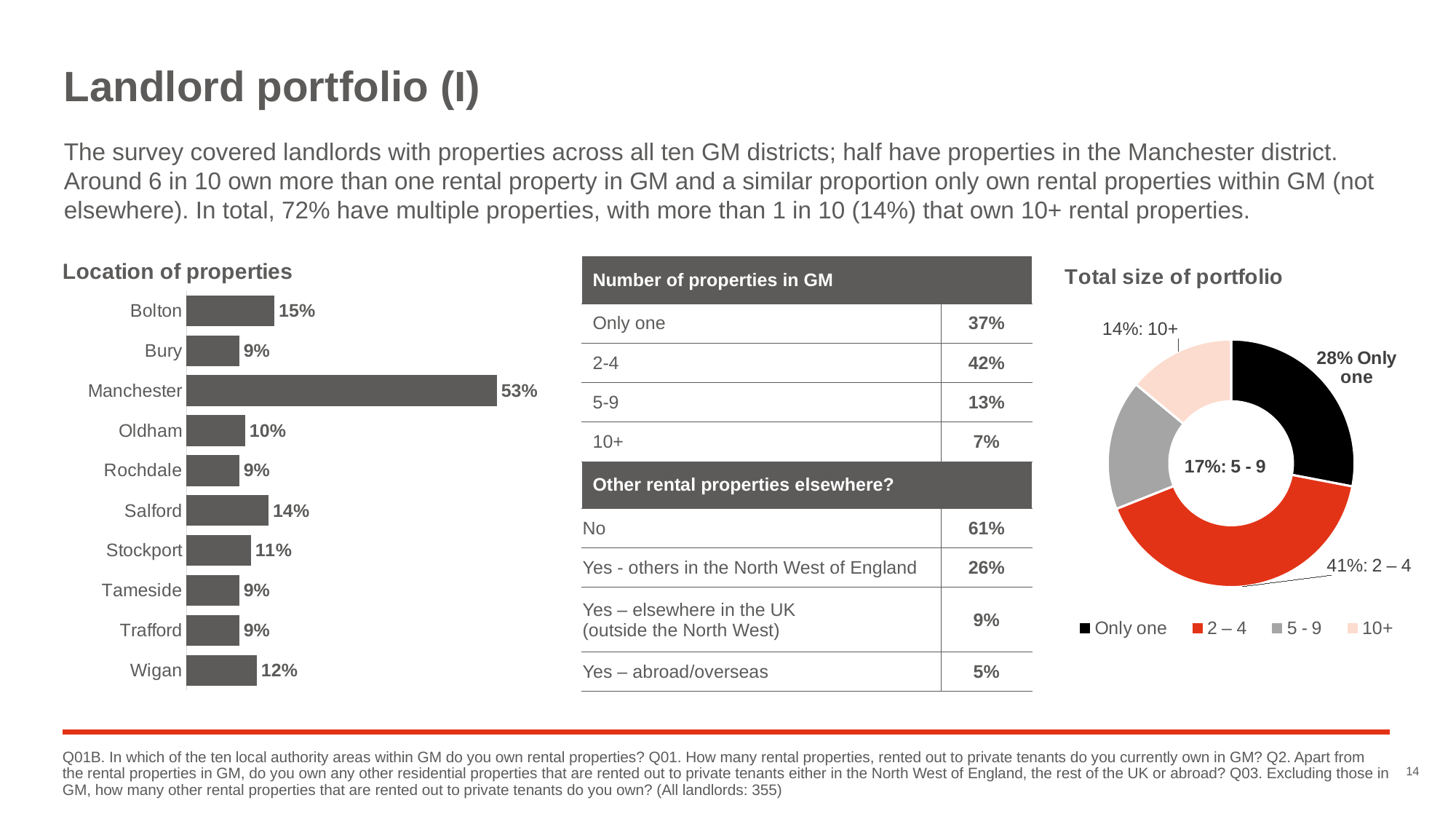
In the 'Location of properties' chart, which is larger, the value for Wigan or the value for Oldham? Wigan In the 'Location of properties' chart, what is the difference between the values for Manchester and Bolton? 38% In the 'Total size of portfolio' chart, what colour is the 'Only one' segment? Black In the 'Location of properties' chart, which district has the highest value? Manchester What kind of chart is the 'Location of properties' chart? Bar chart In the 'Total size of portfolio' chart, what is the value for '10+'? 14% How many districts are shown in the 'Location of properties' chart? 10 How many entries does the legend of the 'Total size of portfolio' chart list? 4 In the 'Total size of portfolio' chart, what share of the pie is '2 – 4'? 41% In the 'Total size of portfolio' chart, which category has the smallest share? 10+ In the 'Location of properties' chart, what is the value for Salford? 14% In the 'Location of properties' chart, what is the value for Manchester? 53%